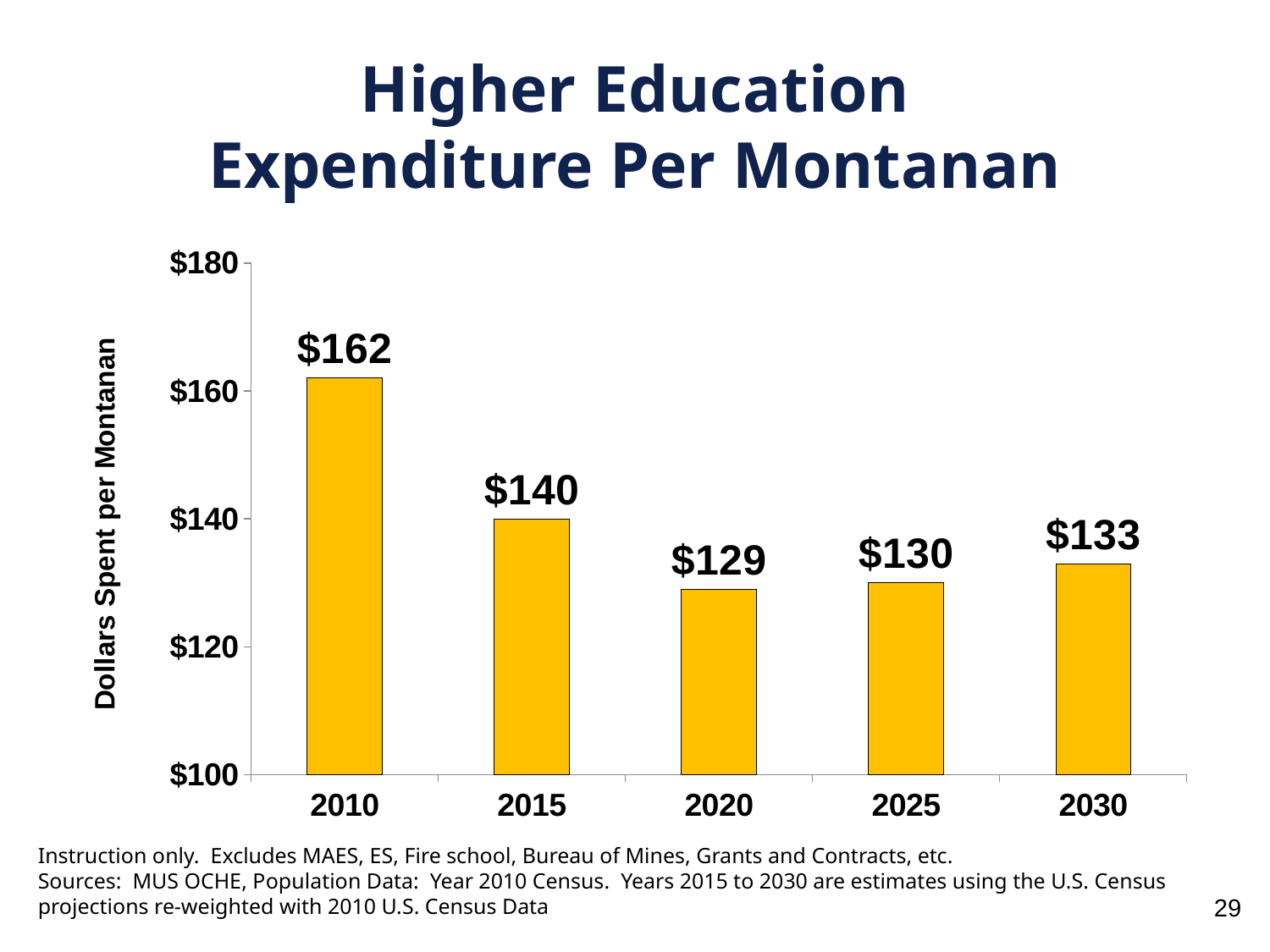
Which is larger, the value for 2015 or the value for 2025? 2015 What kind of chart is shown on the slide? bar chart Which year has the lowest expenditure per Montanan? 2020 Which year has the highest expenditure per Montanan? 2010 What is the value shown for 2030? $133 Is the value for 2025 greater or less than $140? less What is the higher education expenditure per Montanan in 2010? $162 What is the label of the vertical axis? Dollars Spent per Montanan What is the value shown for 2020? $129 How many years are shown on the x axis? 5 What is the difference between the 2030 and 2020 values? $4 What is the difference between the 2010 and 2015 values? $22